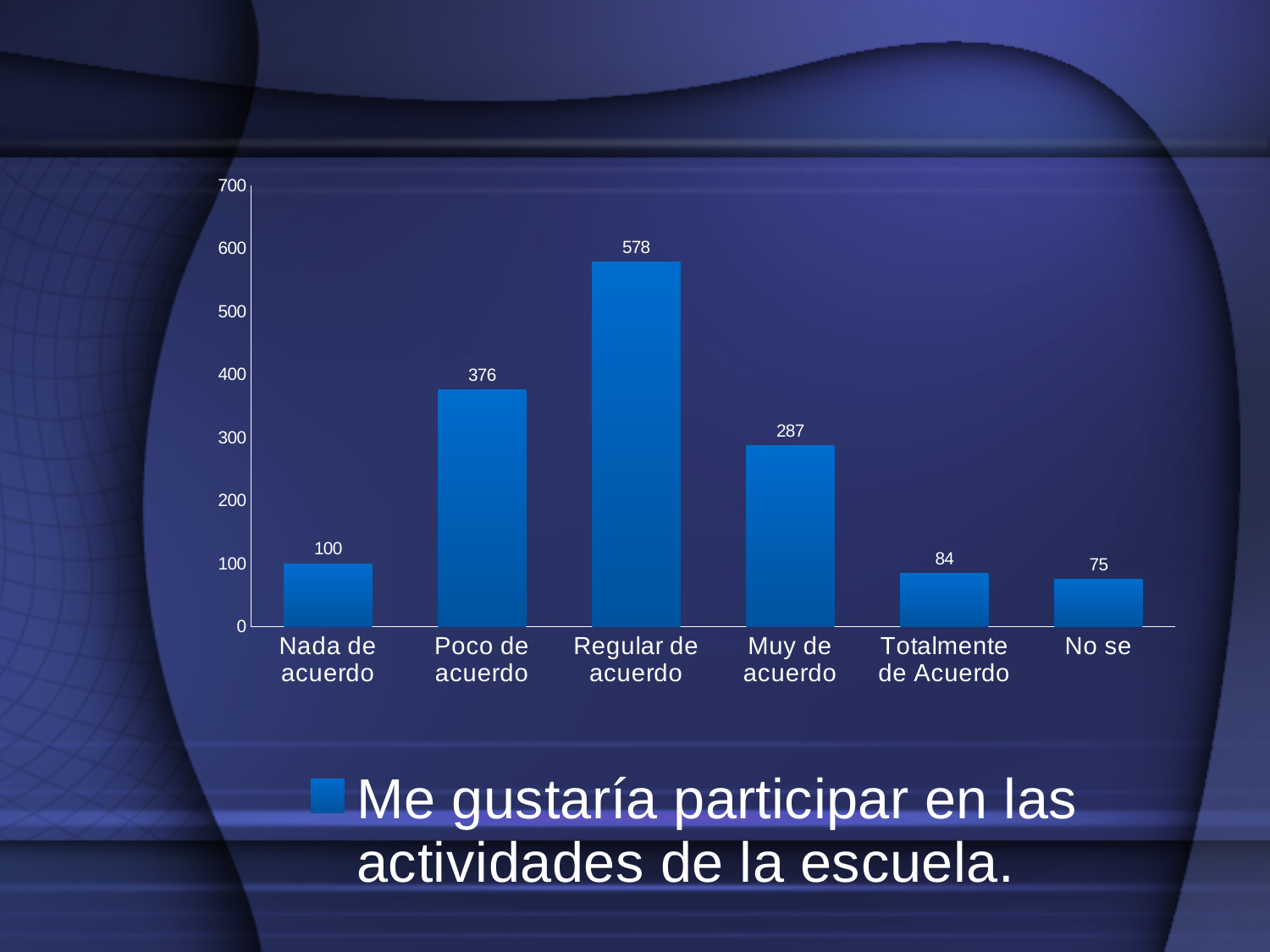
What is the difference between the values for "Regular de acuerdo" and "No se"? 503 What kind of chart is shown on the slide? bar chart What is the value for "No se"? 75 Which category has the highest value? Regular de acuerdo Is the value for "Muy de acuerdo" greater or less than 200? greater Which is larger, the value for "Totalmente de Acuerdo" or the value for "Nada de acuerdo"? Nada de acuerdo What is the value for "Nada de acuerdo"? 100 What is the difference between the values for "Poco de acuerdo" and "Muy de acuerdo"? 89 How many categories are shown on the x axis? 6 What is the value for "Regular de acuerdo"? 578 Which category has the lowest value? No se What is the highest value shown on the y axis? 700